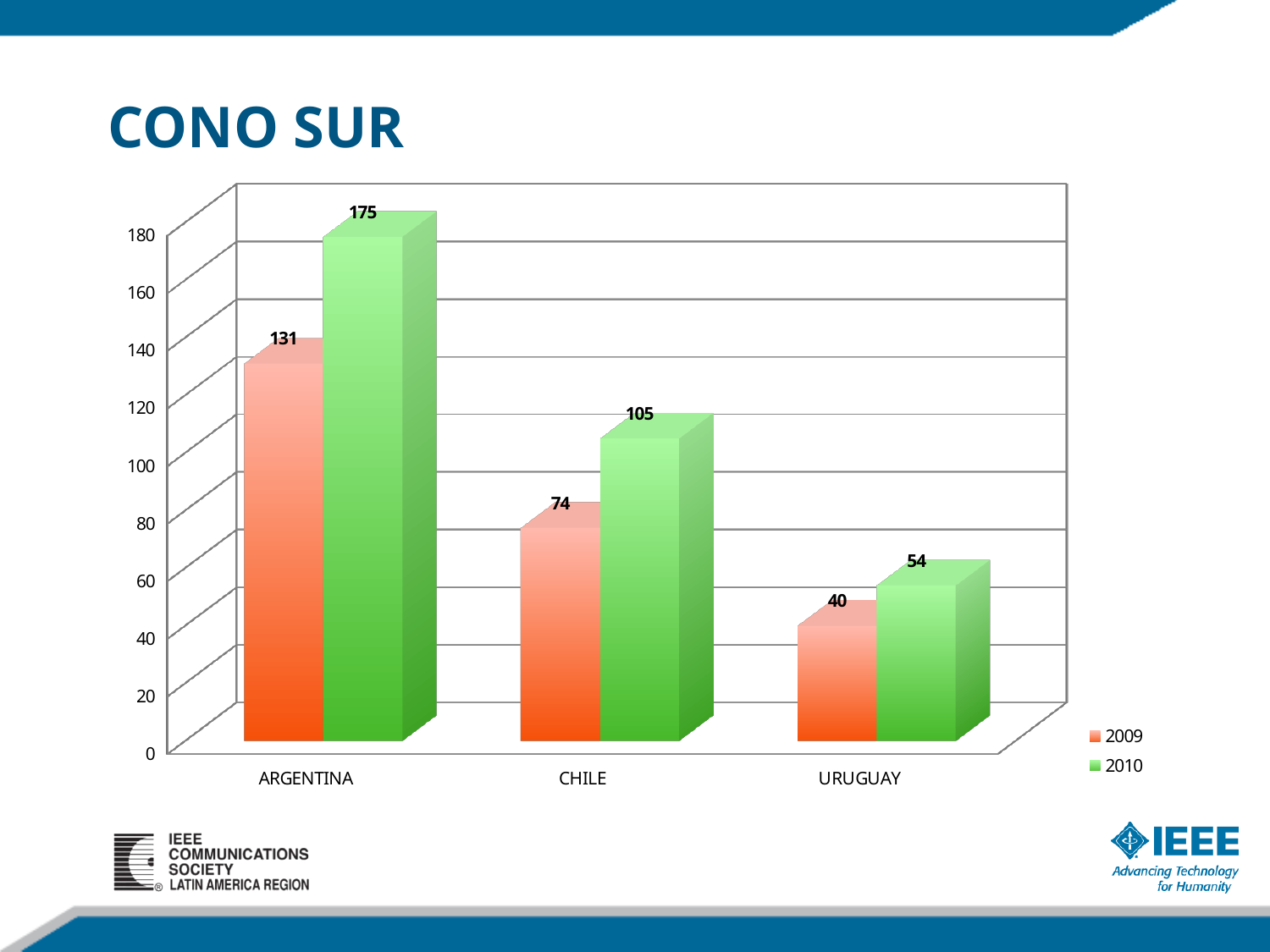
Which country has the highest value in 2009? Argentina Which is larger: the 2009 value for Chile or the 2010 value for Uruguay? 2009 value for Chile What is the value for Chile in 2009? 74 How many countries are shown on the x axis? 3 What is the difference between the 2010 and 2009 values for Argentina? 44 What is the title of the slide containing the chart? CONO SUR What is the difference between the 2010 values for Chile and Uruguay? 51 What is the value for Uruguay in 2010? 54 What is the value for Argentina in 2010? 175 Which country has the lowest value in 2010? Uruguay How many series does the legend list? 2 What kind of chart is shown on the slide? Bar chart